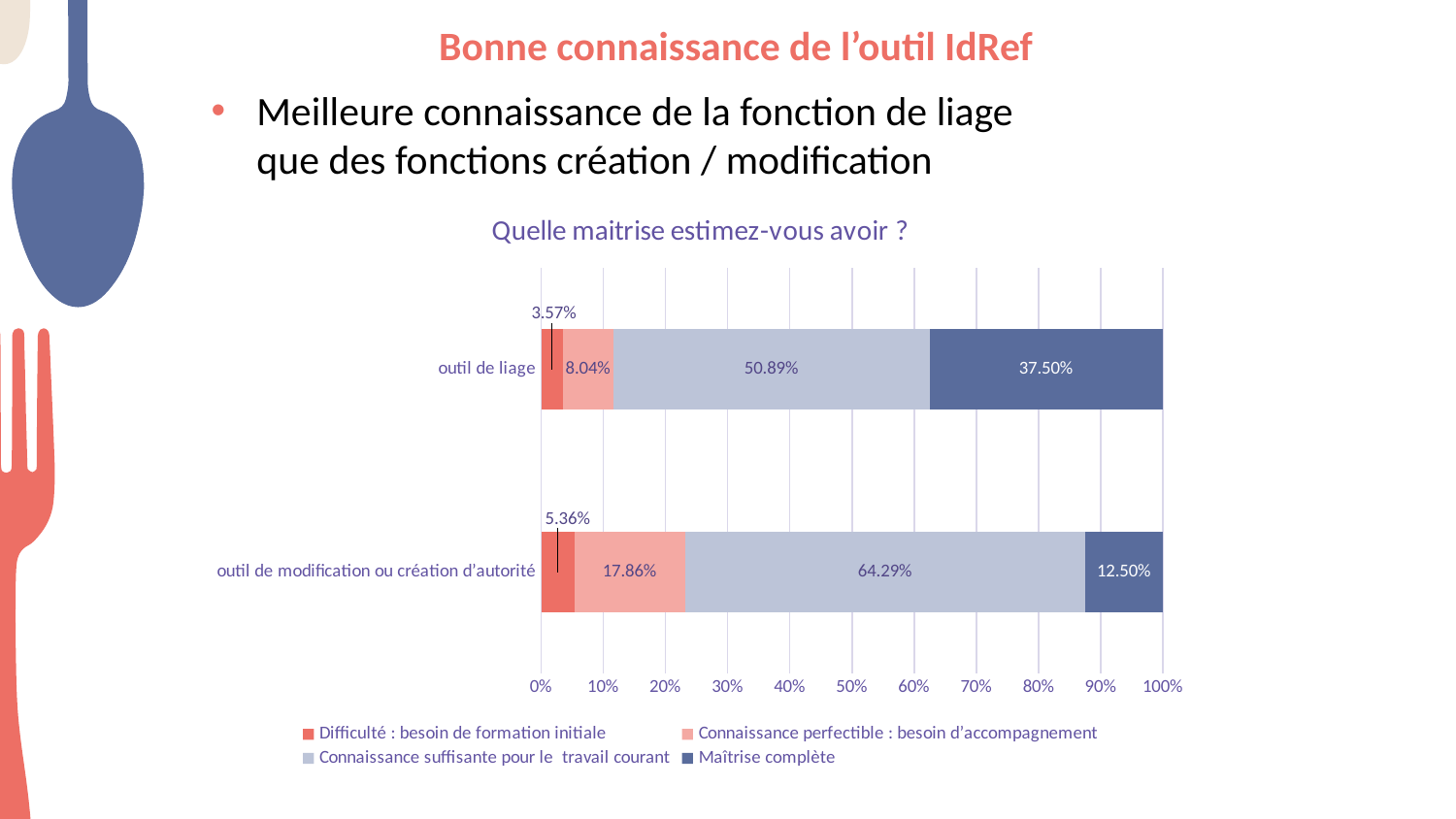
How many categories are plotted on the chart? 2 What is the difference between the "Connaissance perfectible : besoin d'accompagnement" values for "outil de modification ou création d'autorité" and "outil de liage"? 9.82% What is the value of "Connaissance perfectible : besoin d'accompagnement" for "outil de modification ou création d'autorité"? 17.86% What is the value of "Difficulté : besoin de formation initiale" for "outil de liage"? 3.57% Which series has the smallest value for "outil de liage"? Difficulté : besoin de formation initiale What is the value of "Connaissance suffisante pour le travail courant" for "outil de modification ou création d'autorité"? 64.29% How many series does the legend list? 4 What is the value of "Maîtrise complète" for "outil de liage"? 37.50% Which series has the largest value for "outil de modification ou création d'autorité"? Connaissance suffisante pour le travail courant What is the title of the chart? Quelle maitrise estimez-vous avoir ? What kind of chart is shown on the slide? Stacked bar chart Which category has the higher value for "Maîtrise complète"? outil de liage